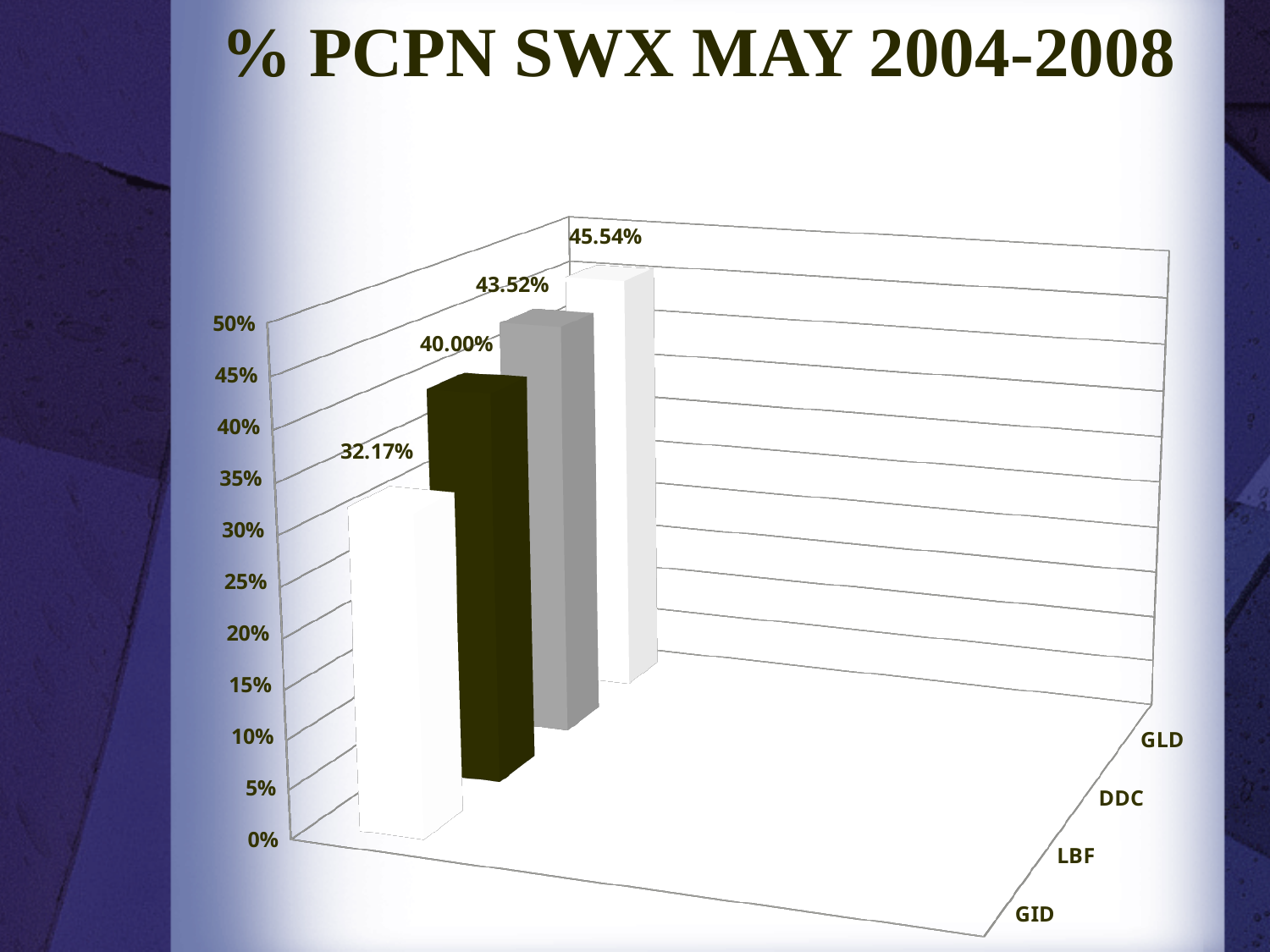
Which is larger, the value for LBF or the value for DDC? DDC What is the value for DDC? 43.52% What is the value for GID? 32.17% How many categories are shown in the chart? 4 What is the difference between the values for GLD and GID? 13.37% Is the value for GID greater or less than 35%? less What is the value for LBF? 40.00% Which category has the highest value? GLD What kind of chart is shown on the slide? bar chart Which category has the lowest value? GID What is the value for GLD? 45.54% What is the title of the chart? % PCPN SWX MAY 2004-2008